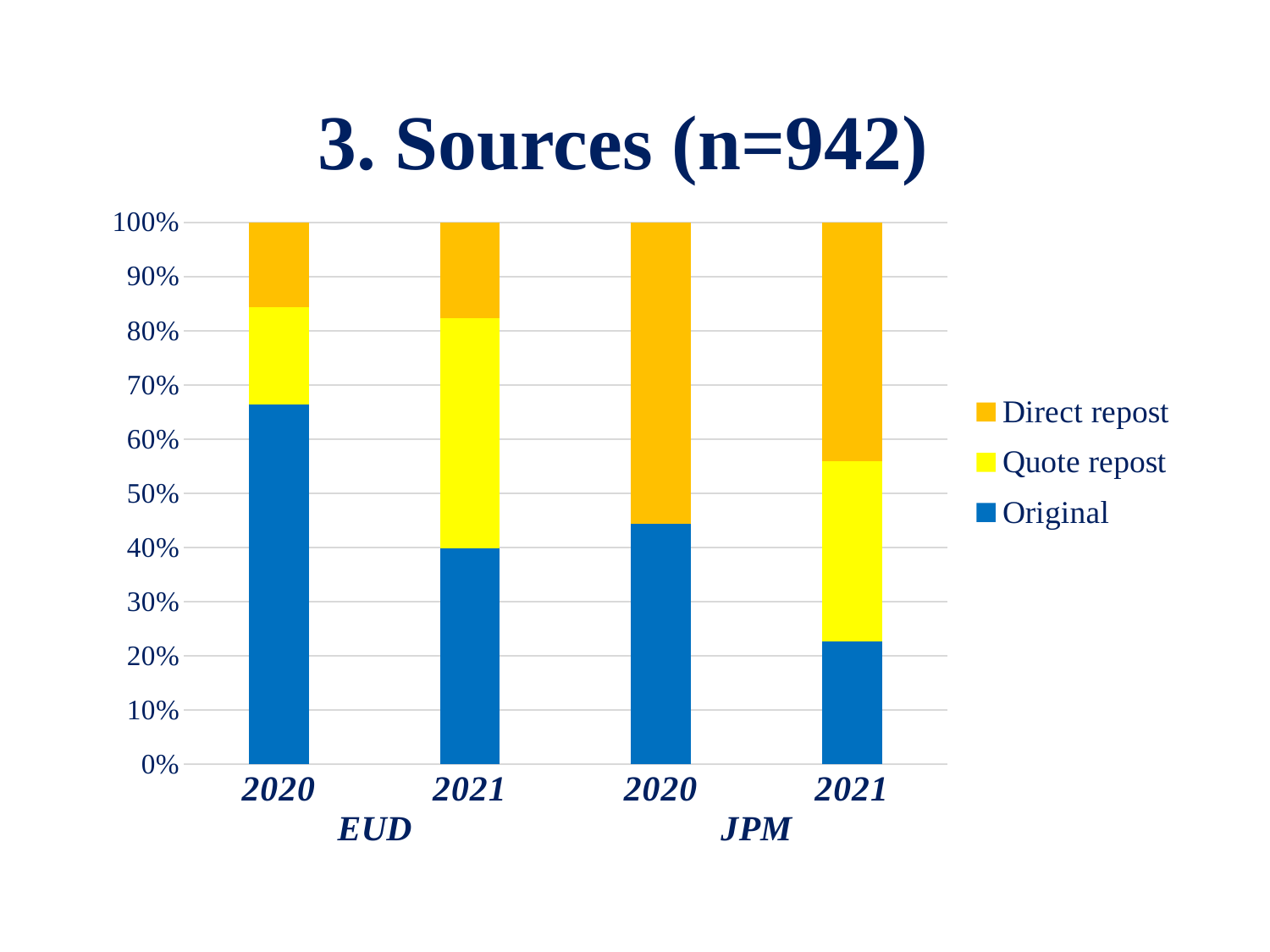
Is the Original share for EUD 2020 greater or less than 60%? greater What kind of chart is shown on the slide? Stacked bar chart How many bars are plotted in the chart? 4 Which bar has the largest Direct repost share? JPM 2020 Which bar has the smallest Original share? JPM 2021 What is the title of the chart? 3. Sources (n=942) Which bar has the largest Quote repost share? EUD 2021 Is the Original share for JPM 2021 greater or less than 30%? less How many series does the legend list? 3 Is the Original share for EUD 2021 greater or less than 50%? less Which bar has the largest Original share? EUD 2020 Which has the larger Original share, EUD 2020 or JPM 2020? EUD 2020